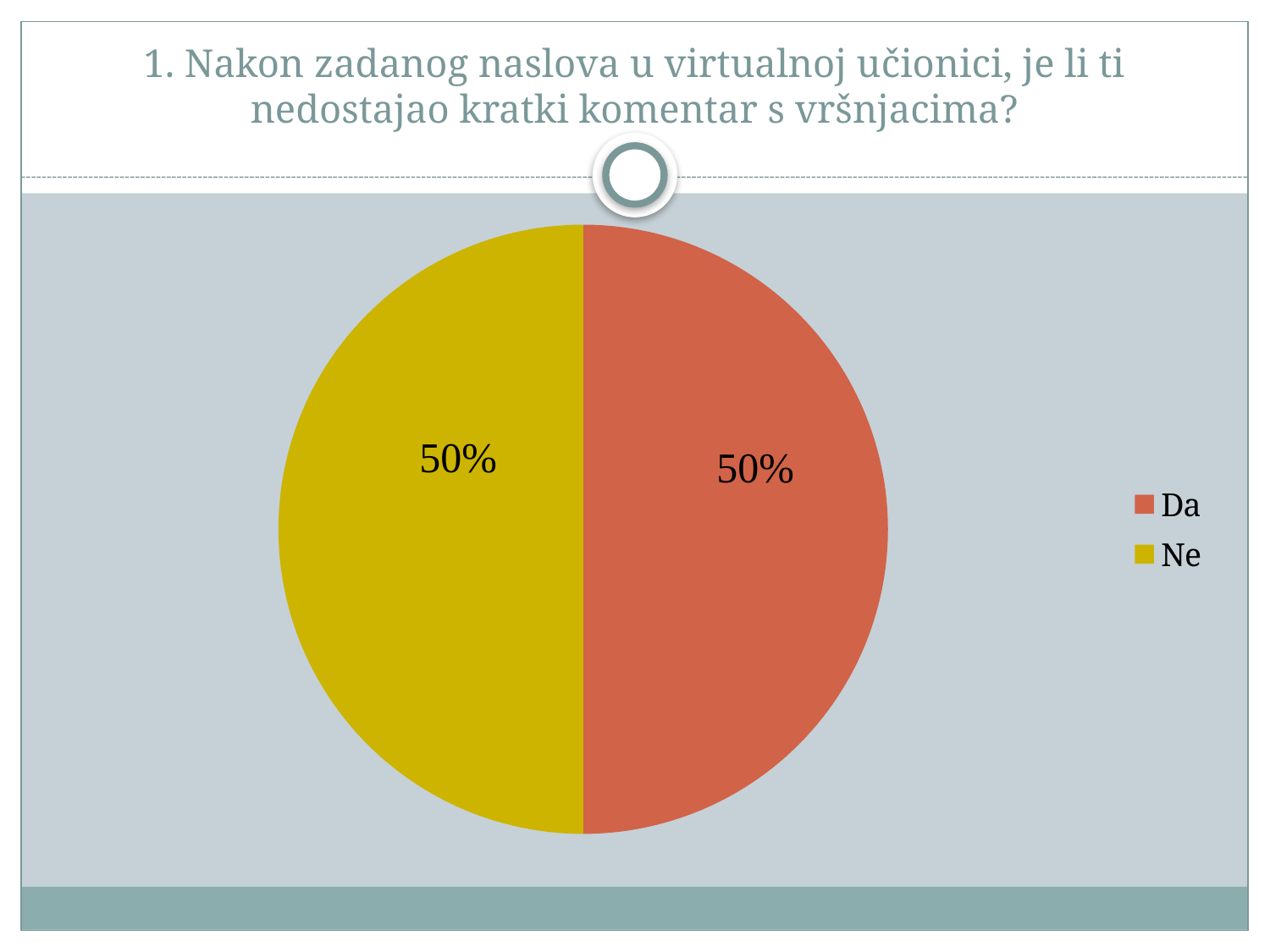
Which colour represents "Ne" in the pie chart? yellow What kind of chart is shown on the slide? pie chart What is the total of the "Da" and "Ne" shares? 100% How many entries does the legend list? 2 How many slices does the pie chart have? 2 What is the difference between the "Da" and "Ne" shares? 0% What share of the pie does the "Ne" slice represent? 50% Is the share for "Da" greater or less than 60%? less What share of the pie does the "Da" slice represent? 50% Which colour represents "Da" in the pie chart? red